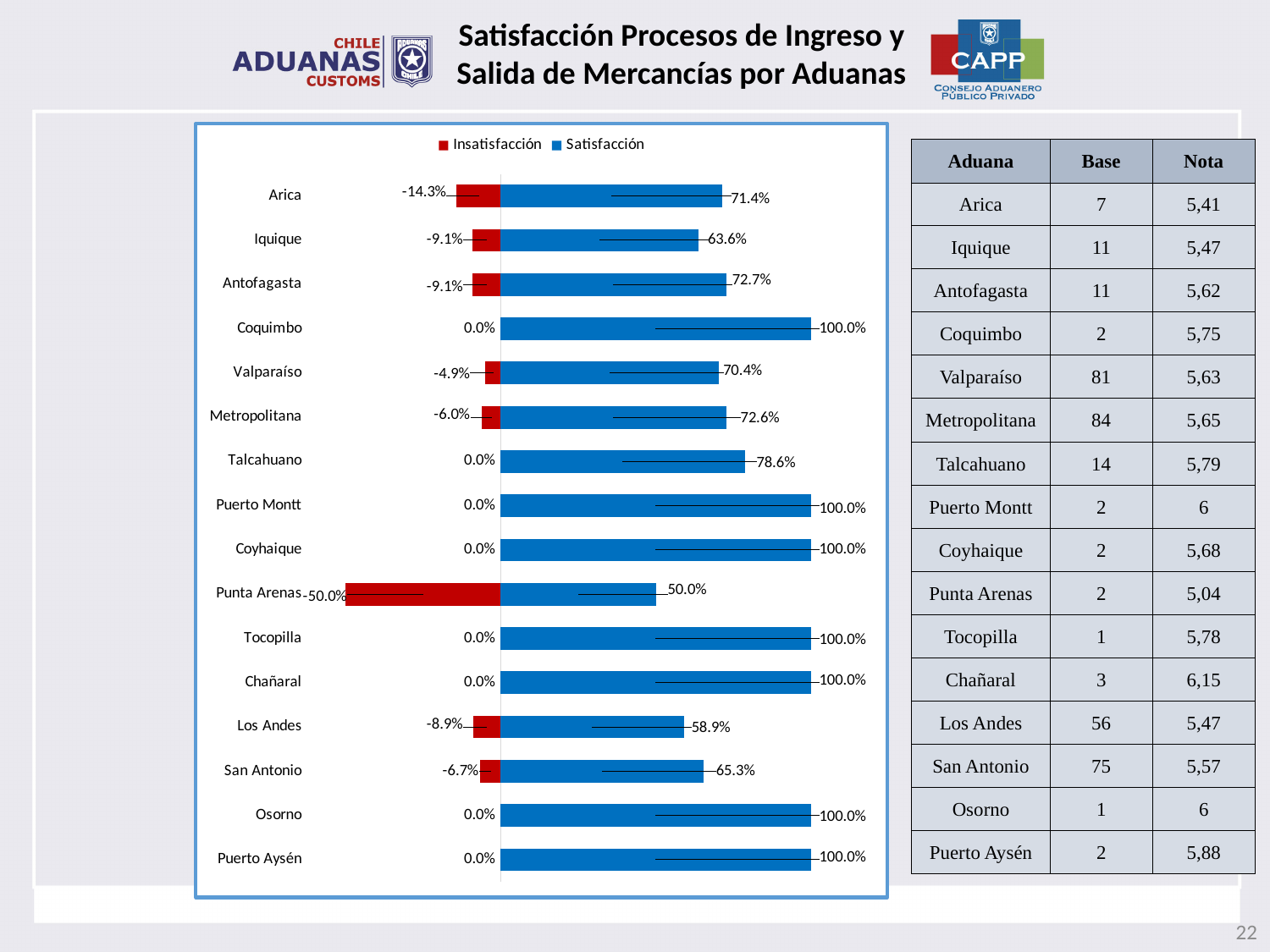
What kind of chart is shown on the slide? Bar chart Which aduana has the lowest Satisfacción value? Punta Arenas What is the Insatisfacción value for Punta Arenas? -50.0% Which has a higher Satisfacción value, Talcahuano or Los Andes? Talcahuano Which aduana has the largest Insatisfacción bar? Punta Arenas What is the Satisfacción value for Arica? 71.4% Which colour represents Insatisfacción in the chart? Red What is the Satisfacción value for Talcahuano? 78.6% What is the Insatisfacción value for Valparaíso? -4.9% How many aduanas are shown on the chart? 16 What is the difference in Satisfacción between Arica and Iquique? 7.8 percentage points How many series does the legend list? 2